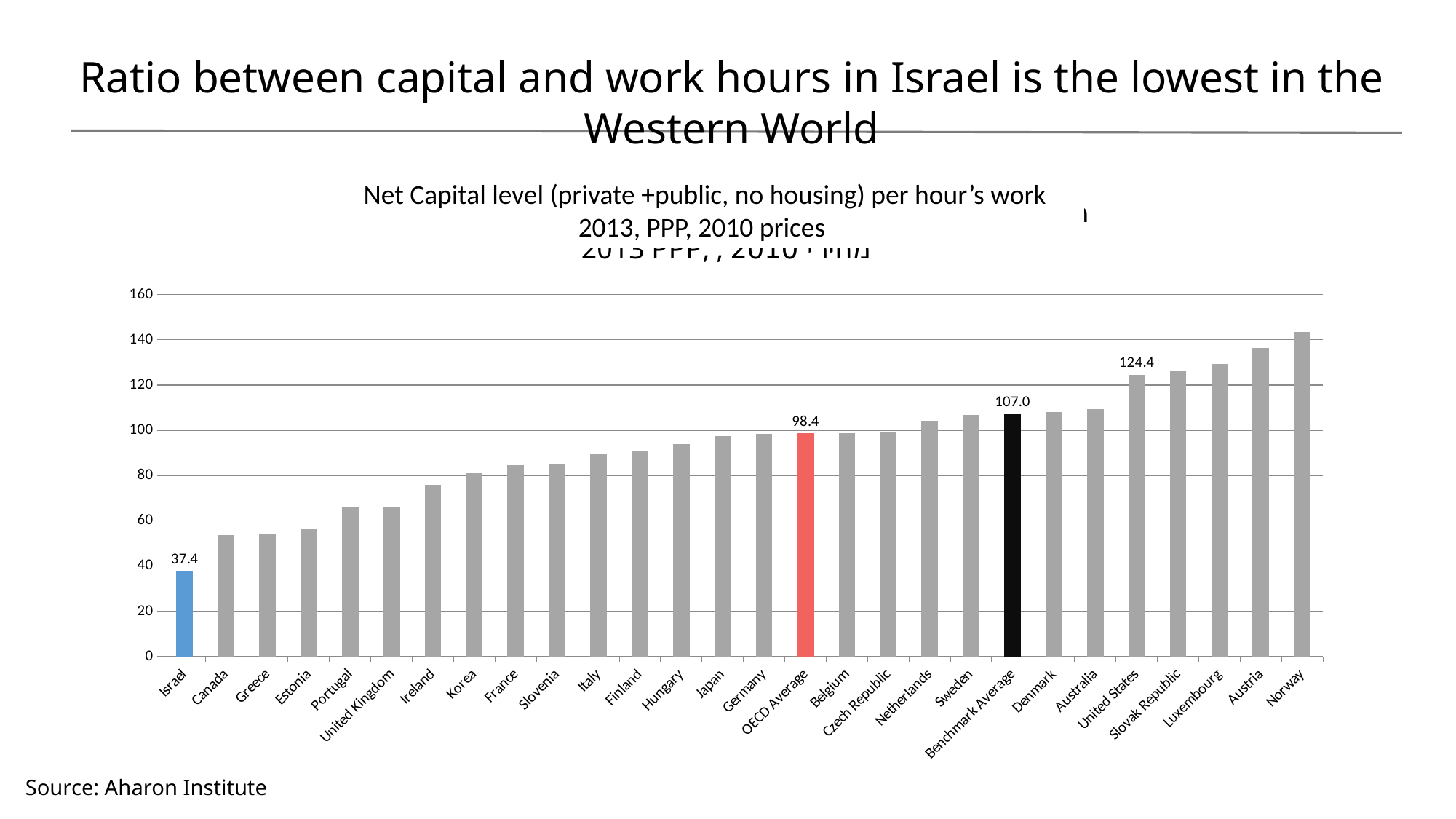
What is the value for the United States? 124.4 What kind of chart is shown on the slide? Bar chart What is the difference between the Benchmark Average and the OECD Average? 8.6 Is the value for Ireland greater or less than 80? less Is the value for Norway greater or less than 140? greater What is the value for the OECD Average? 98.4 What is the value for Israel? 37.4 Which is larger, the value for Canada or the value for Portugal? Portugal Which country has the highest value? Norway What is the value for the Benchmark Average? 107.0 What is the difference between the United States value and the Israel value? 87.0 Which country has the lowest value? Israel